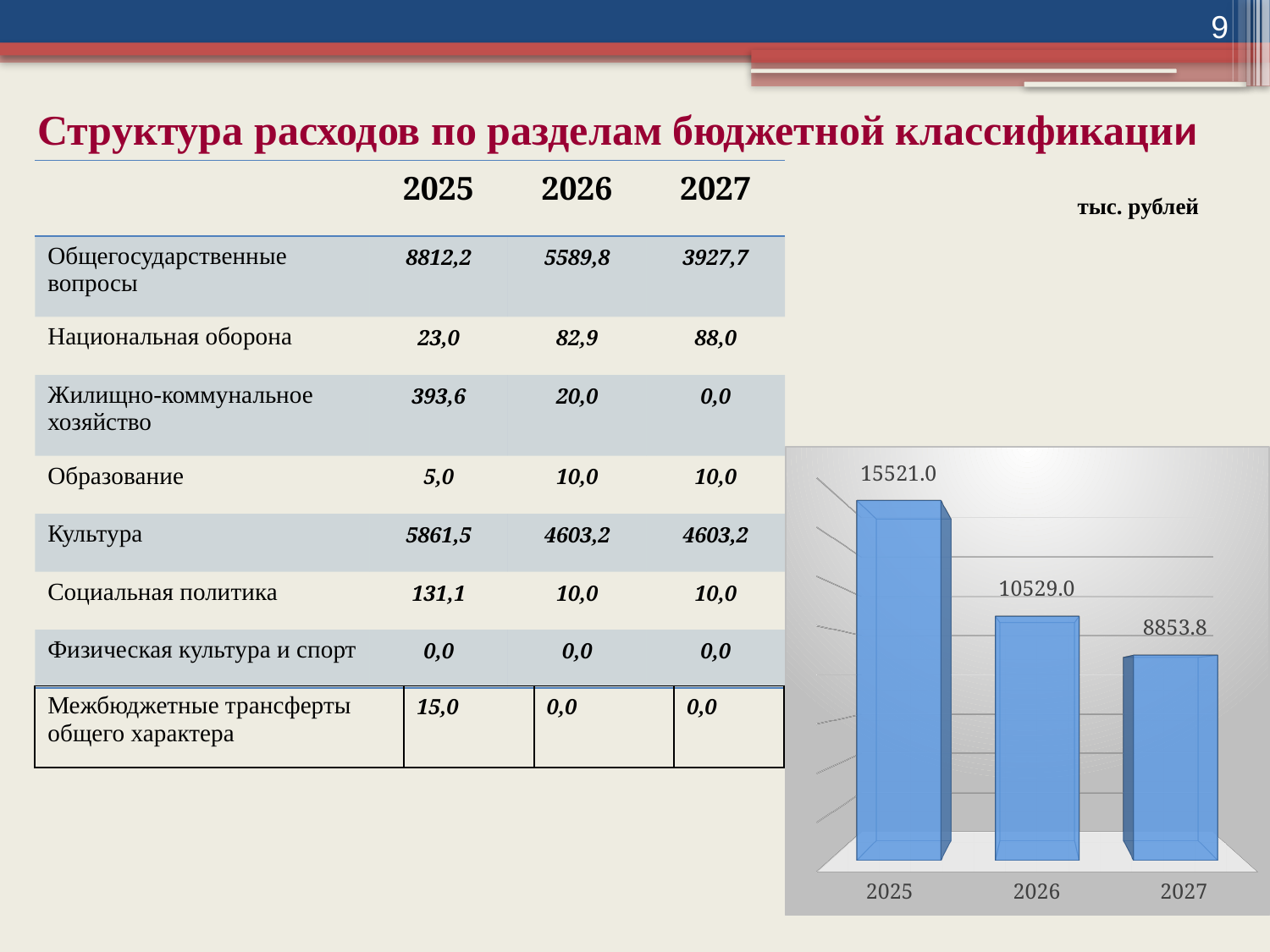
What is the difference between the chart values for 2025 and 2027? 6667.2 What kind of chart is shown on the slide? bar chart What value does the bar chart show for 2027? 8853.8 Which year has the lowest bar in the chart? 2027 In the chart, is the value for 2026 larger or smaller than the value for 2027? larger What value does the bar chart show for 2026? 10529.0 Which year has the highest bar in the chart? 2025 What value does the bar chart show for 2025? 15521.0 Do the values in the chart rise or fall from 2025 to 2027? fall What is the difference between the chart values for 2025 and 2026? 4992.0 How many bars are plotted in the chart? 3 What is the difference between the chart values for 2026 and 2027? 1675.2